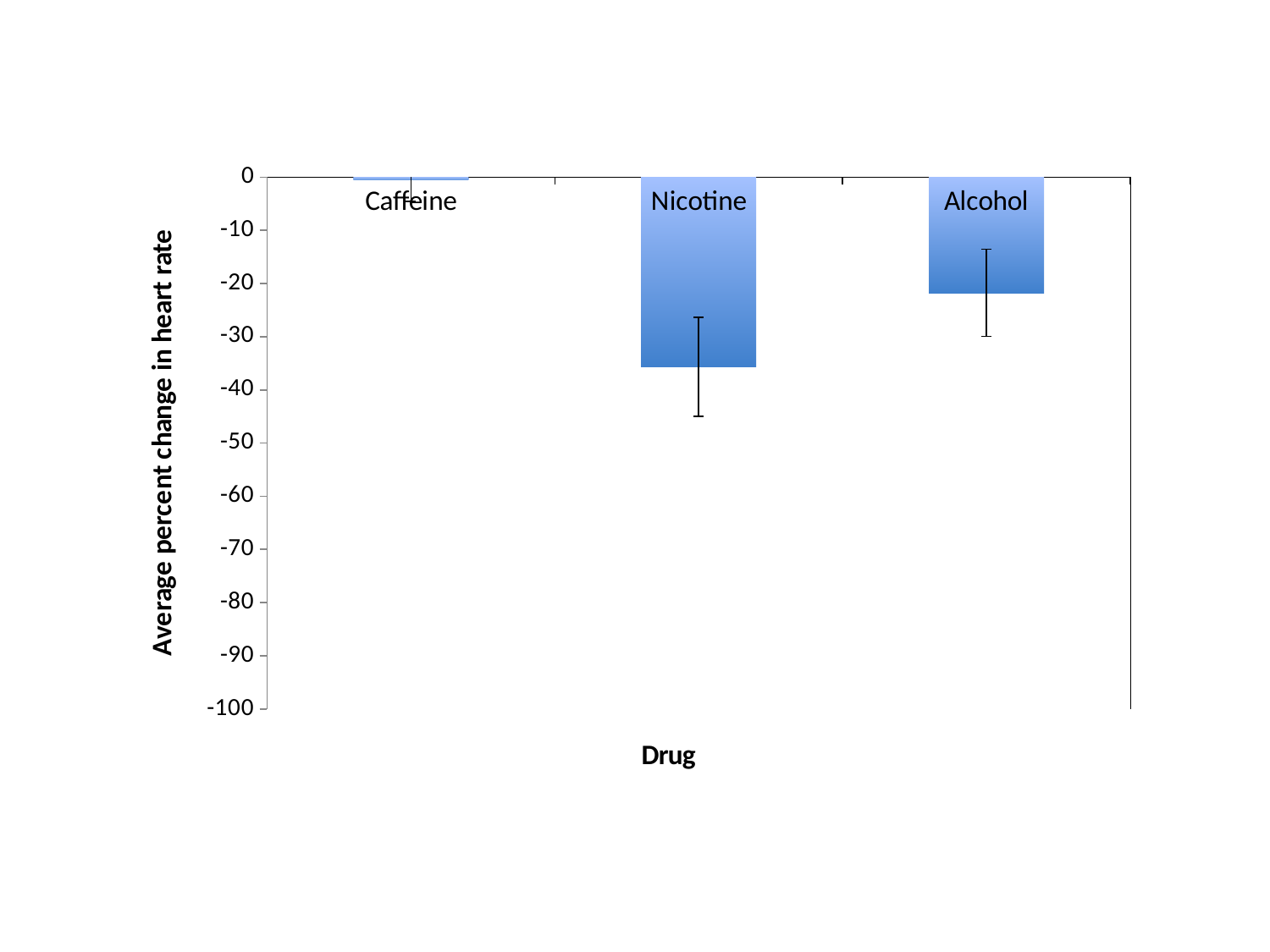
Is the value for Nicotine greater or less than -30? less Is the value for Alcohol greater or less than -10? less How many drugs (categories) are plotted on the chart? 3 Which drug shows a larger decrease in heart rate, Nicotine or Alcohol? Nicotine Which has the larger value, Nicotine or Alcohol? Alcohol Is the value for Nicotine greater or less than -40? greater Which drug has the lowest (most negative) average percent change in heart rate? Nicotine What kind of chart is shown on the slide? bar chart What is the title of the vertical axis? Average percent change in heart rate What is the title of the horizontal axis? Drug Which drug has the highest average percent change in heart rate? Caffeine